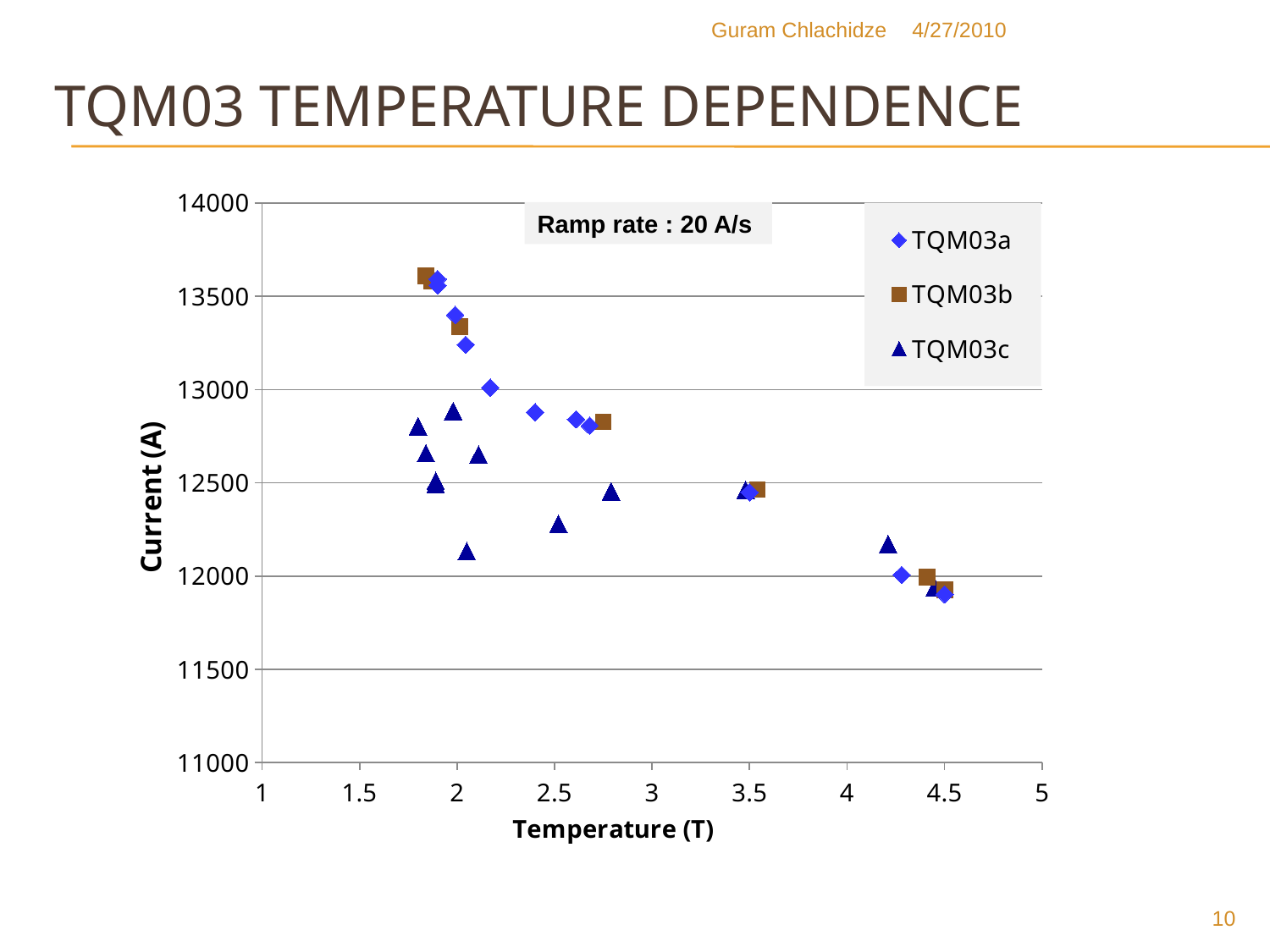
Is the TQM03c value at about 2 T (the lowest triangle) greater or less than 12500? less How many series does the legend list? 3 At about 2 T, which series has the larger current, TQM03a or TQM03c? TQM03a Is the TQM03c value at about 4.2 T greater or less than 12000? greater What kind of chart is shown on the slide? scatter chart What ramp rate is stated in the annotation on the chart? 20 A/s Is the TQM03a value at about 2.4 T greater or less than 13000? less Which series is plotted with triangle markers? TQM03c Does the current rise or fall as temperature increases along the x axis? fall